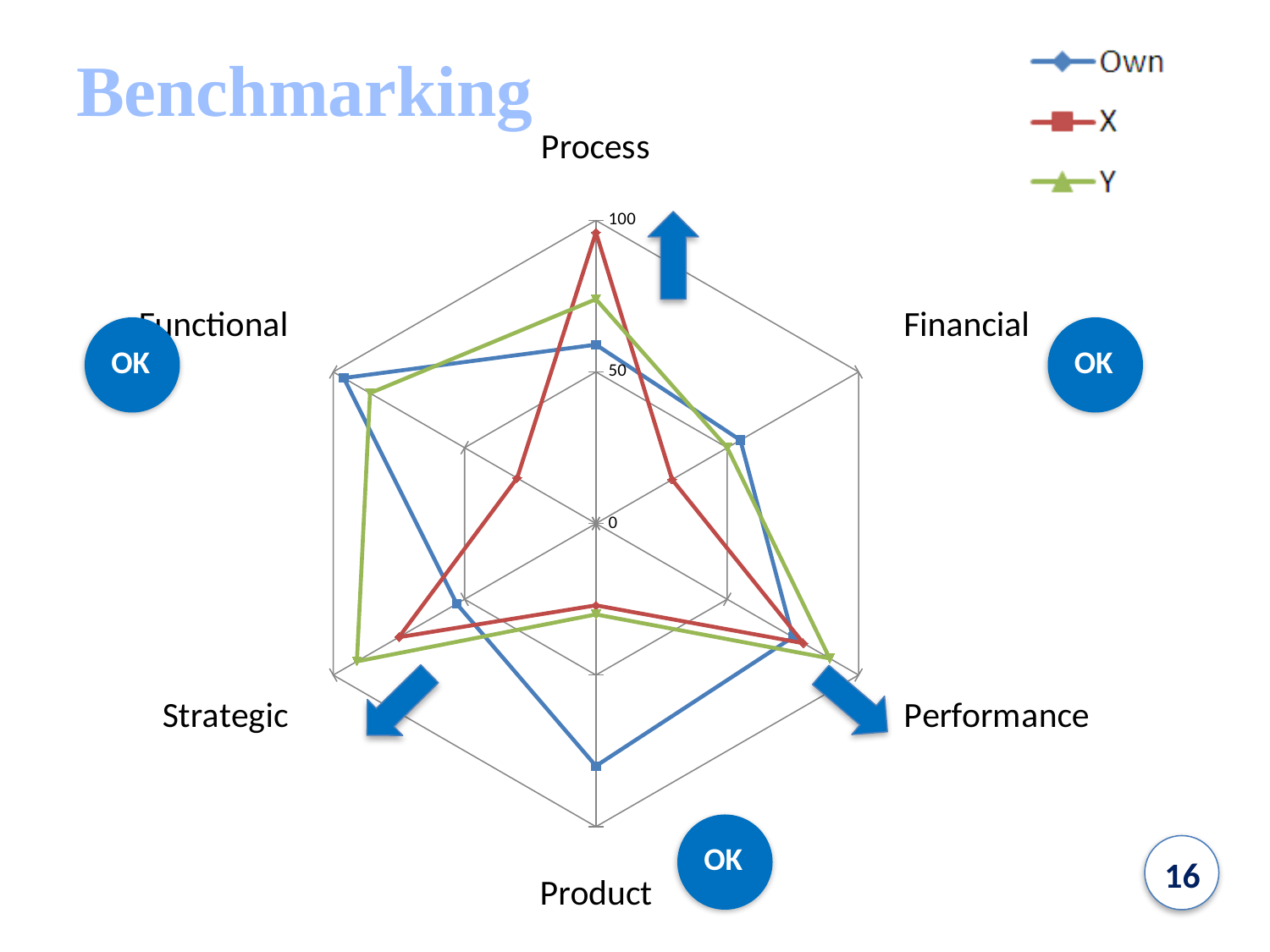
Which series has the lowest value for Product? X Is the value of series Y for Process greater or less than 50? greater What are the names of the three series in the legend? Own, X, Y Which series has the lowest value for Strategic? Own Which series has the highest value for Process? X How many categories (axes) does the radar chart have? 6 Is the value of series Own for Product greater or less than 50? greater Is the value of series X for Functional greater or less than 50? less How many series does the legend list? 3 What kind of chart is shown on the slide? radar chart Which is larger for Product: the value of series Own or series X? Own